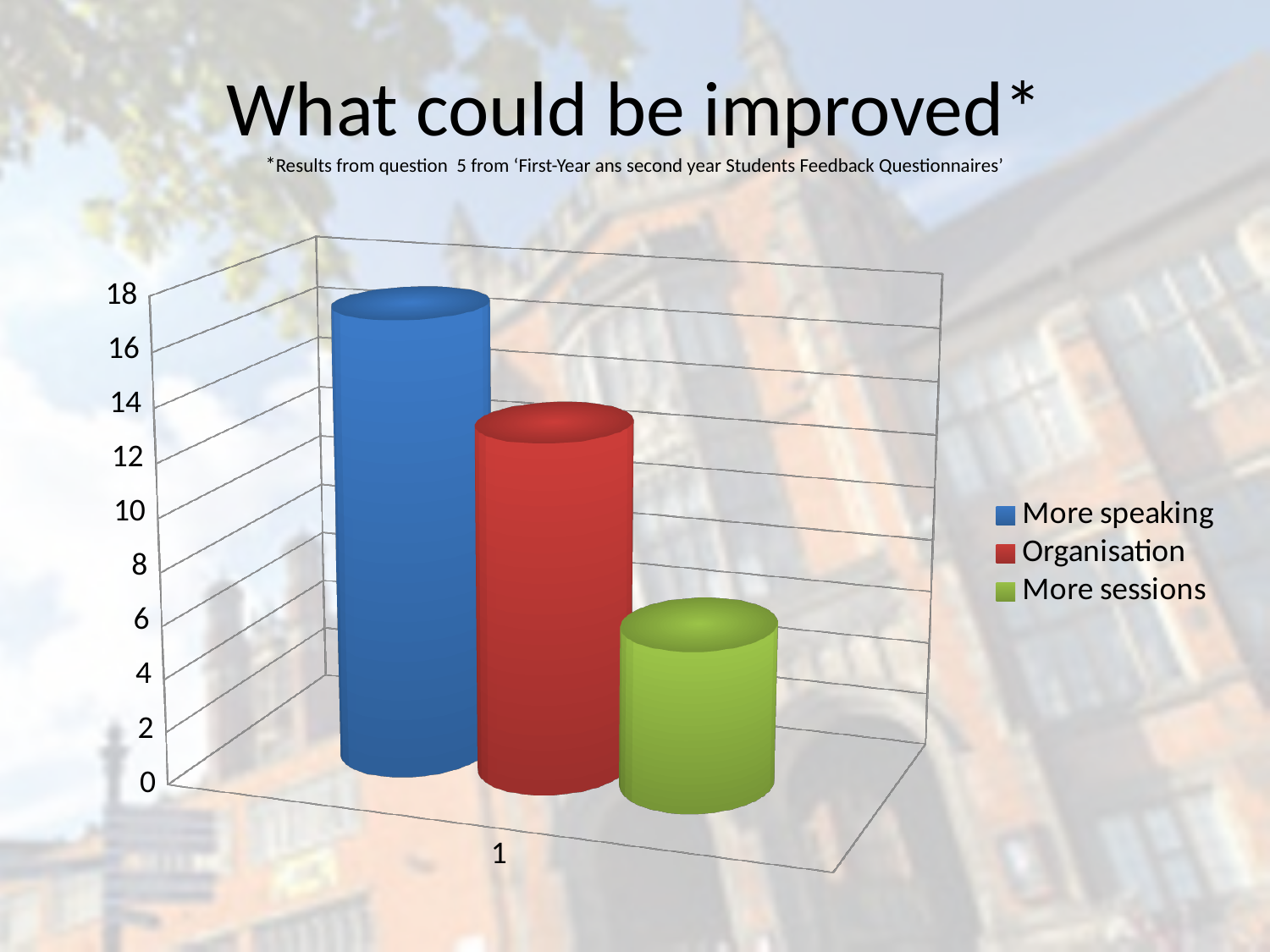
Which is larger, the value for More speaking or the value for Organisation? More speaking How many series does the legend list? 3 What is the title of the slide containing the chart? What could be improved* Which series has the highest value? More speaking Is the value for Organisation greater or less than 16? less Which is larger, the value for Organisation or the value for More sessions? Organisation What kind of chart is shown on the slide? bar chart Which series has the lowest value? More sessions Which colour represents the Organisation series in the legend? red Is the value for More sessions greater or less than 10? less Is the value for More speaking greater or less than 14? greater